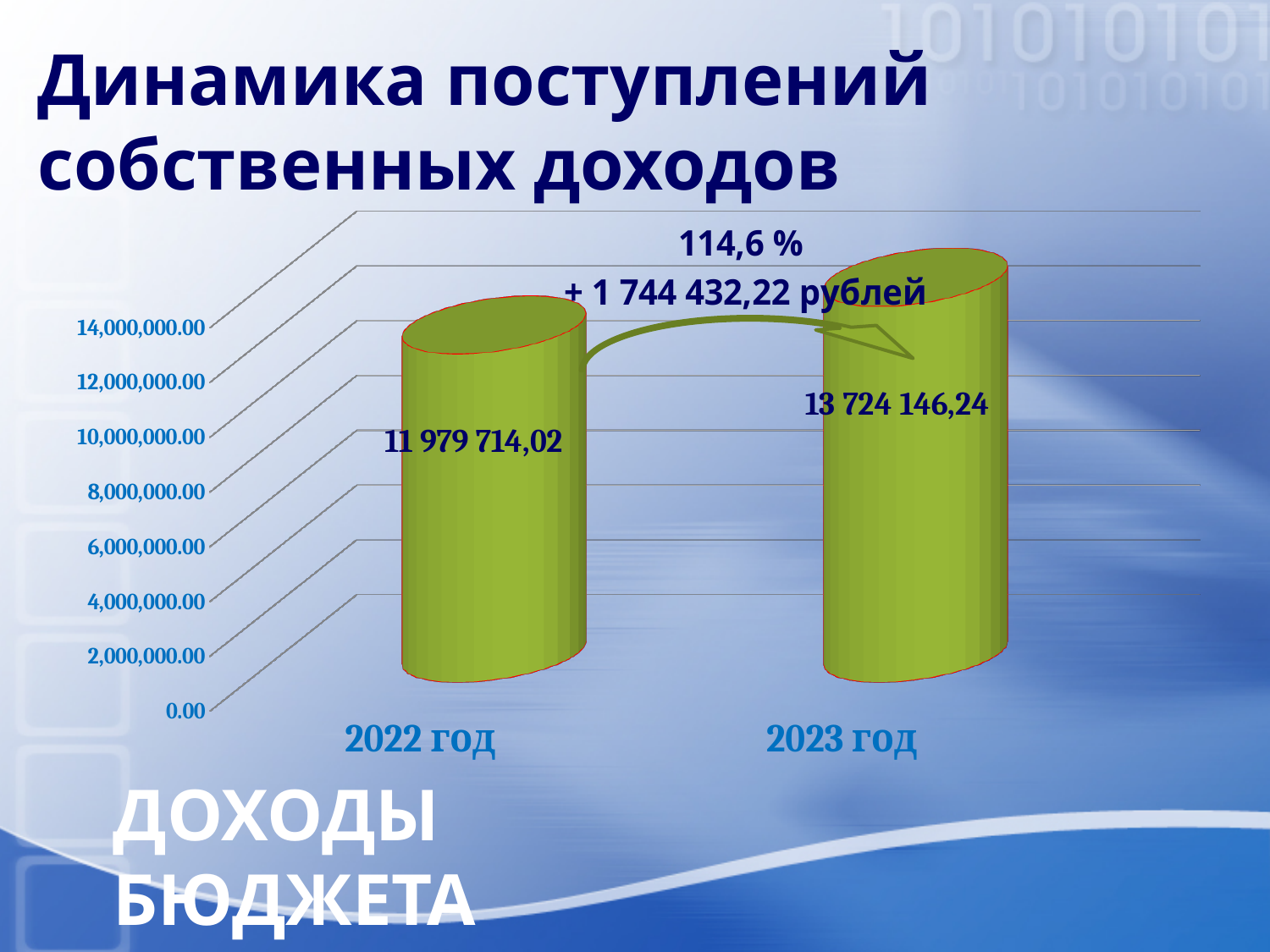
Which year has the higher value? 2023 год What percentage is shown in the annotation above the bars? 114,6 % What kind of chart is shown on the slide? bar chart Is the value for 2022 год greater or less than 14,000,000.00? less What is the difference between the values for 2023 год and 2022 год? 1 744 432,22 What is the value for 2023 год? 13 724 146,24 Is the value for 2023 год greater or less than 12,000,000.00? greater Is the value for 2022 год larger or smaller than the value for 2023 год? smaller Do the values rise or fall from 2022 год to 2023 год? rise How many categories are shown on the x axis? 2 What is the value for 2022 год? 11 979 714,02 Which year has the lower value? 2022 год